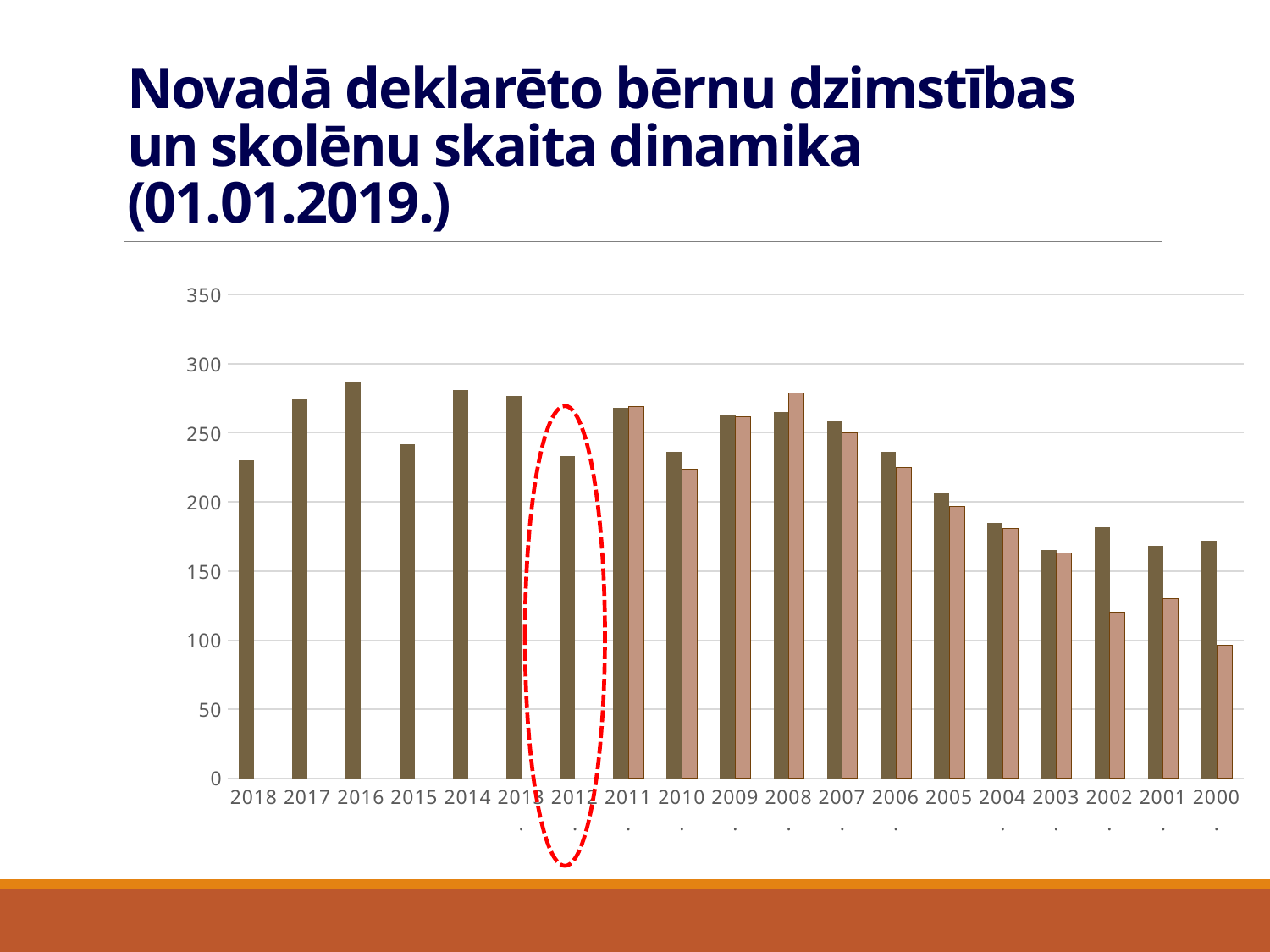
What kind of chart is shown on the slide? bar chart Is the dark bar for 2016 greater or less than 250? greater Do the light bars generally rise or fall going from 2011 to 2000 along the x axis? fall For 2008, which bar is taller, the dark bar or the light bar? the light bar Is the light bar for 2008 greater or less than 250? greater Which year has the lowest light bar? 2000 Is the light bar for 2001 greater or less than 100? greater Which year on the x axis is highlighted with a red dashed circle? 2012 Which year has the highest light bar? 2008 How many years are shown on the x axis of the chart? 19